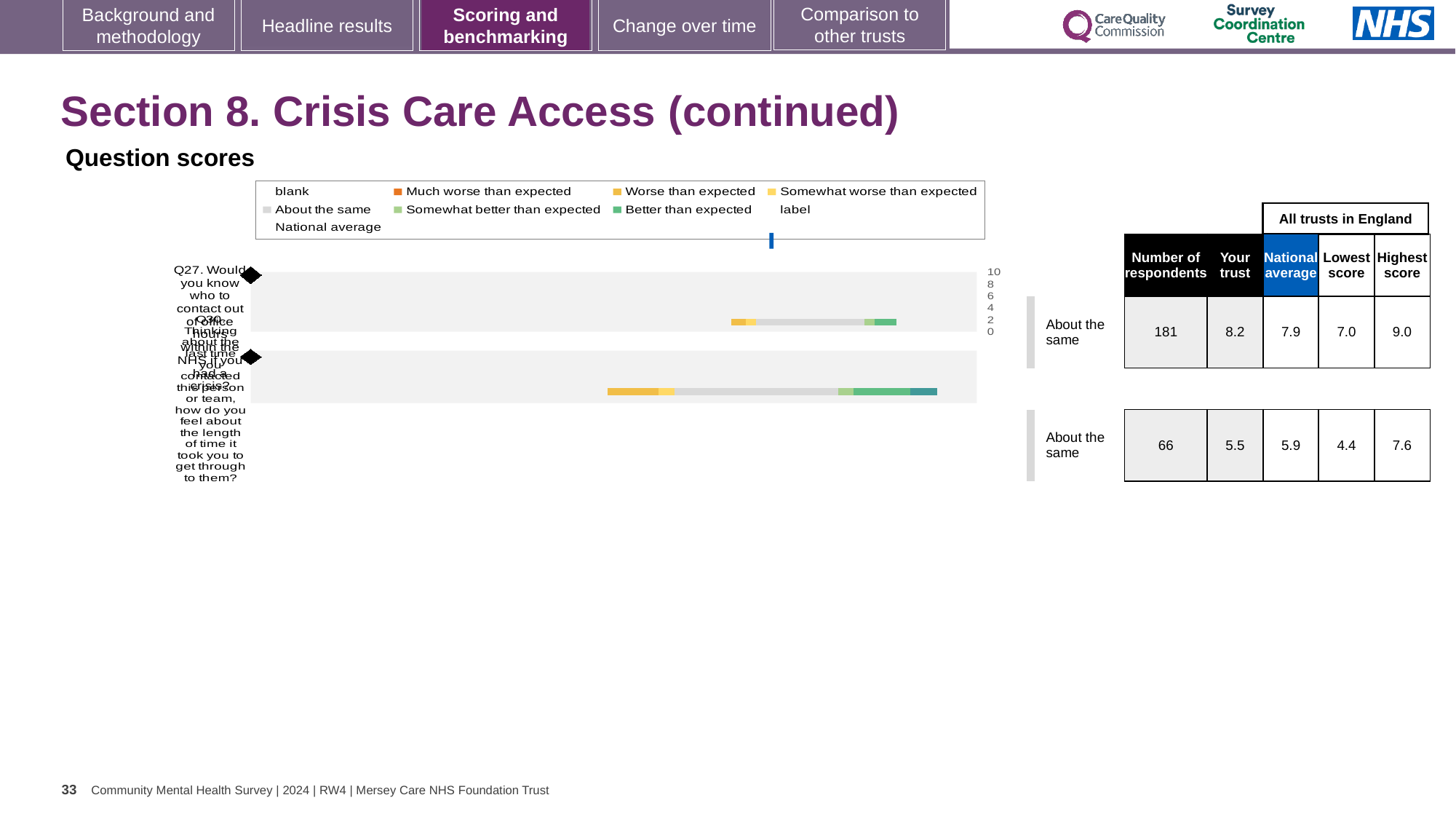
What benchmark category is shown next to both question rows in the chart? About the same In the table beside the chart, what is the national average for the first question row (Q27)? 7.9 What kind of chart is shown under 'Question scores'? bar chart In the table beside the chart, what is the 'Your trust' score for the first question row (Q27)? 8.2 In the table beside the chart, how many respondents answered the second question row (Q29)? 66 In the table beside the chart, what is the 'Your trust' score for the second question row (Q29)? 5.5 Which question row has the higher 'Your trust' score, Q27 or Q29? Q27 What is the difference between the 'Your trust' score and the national average for the first question row (Q27)? 0.3 How many question rows are plotted in the Question scores chart? 2 In the table beside the chart, what is the highest score across all trusts in England for the second question row (Q29)? 7.6 Which is larger for the second question row (Q29): the 'Your trust' score or the national average? National average What is the maximum value shown on the chart's axis? 10